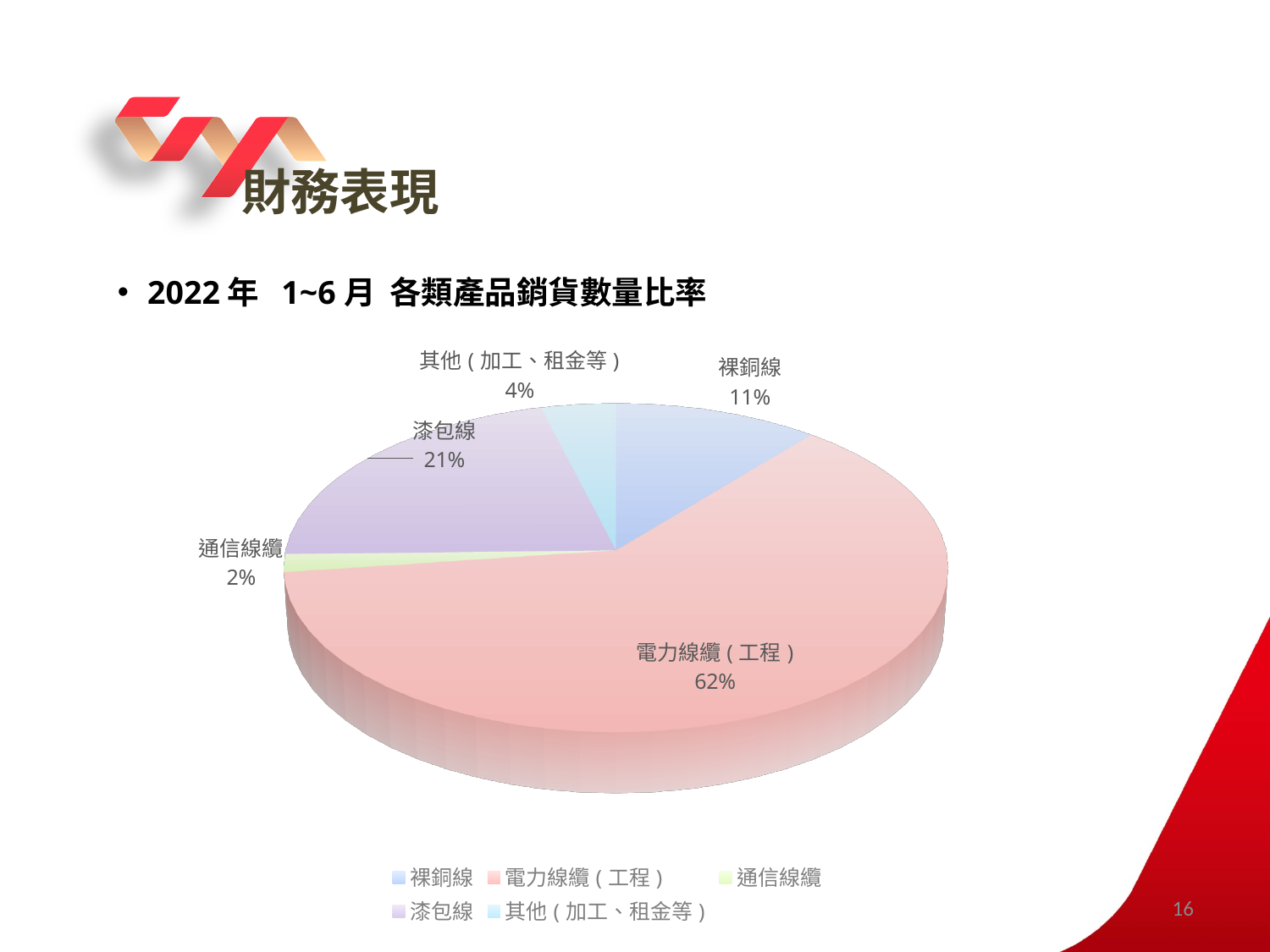
What share of the pie does 裸銅線 have? 11% What share of the pie does 漆包線 have? 21% What is the difference in percentage points between 電力線纜(工程) and 漆包線? 41 What share of the pie does 其他(加工、租金等) have? 4% What kind of chart is shown on the slide? Pie chart What is the title of the chart? 2022年 1~6月 各類產品銷貨數量比率 Which category has the largest share of the pie? 電力線纜(工程) Which category has the smallest share of the pie? 通信線纜 Which is larger, the share for 裸銅線 or the share for 其他(加工、租金等)? 裸銅線 How many categories are shown in the pie chart? 5